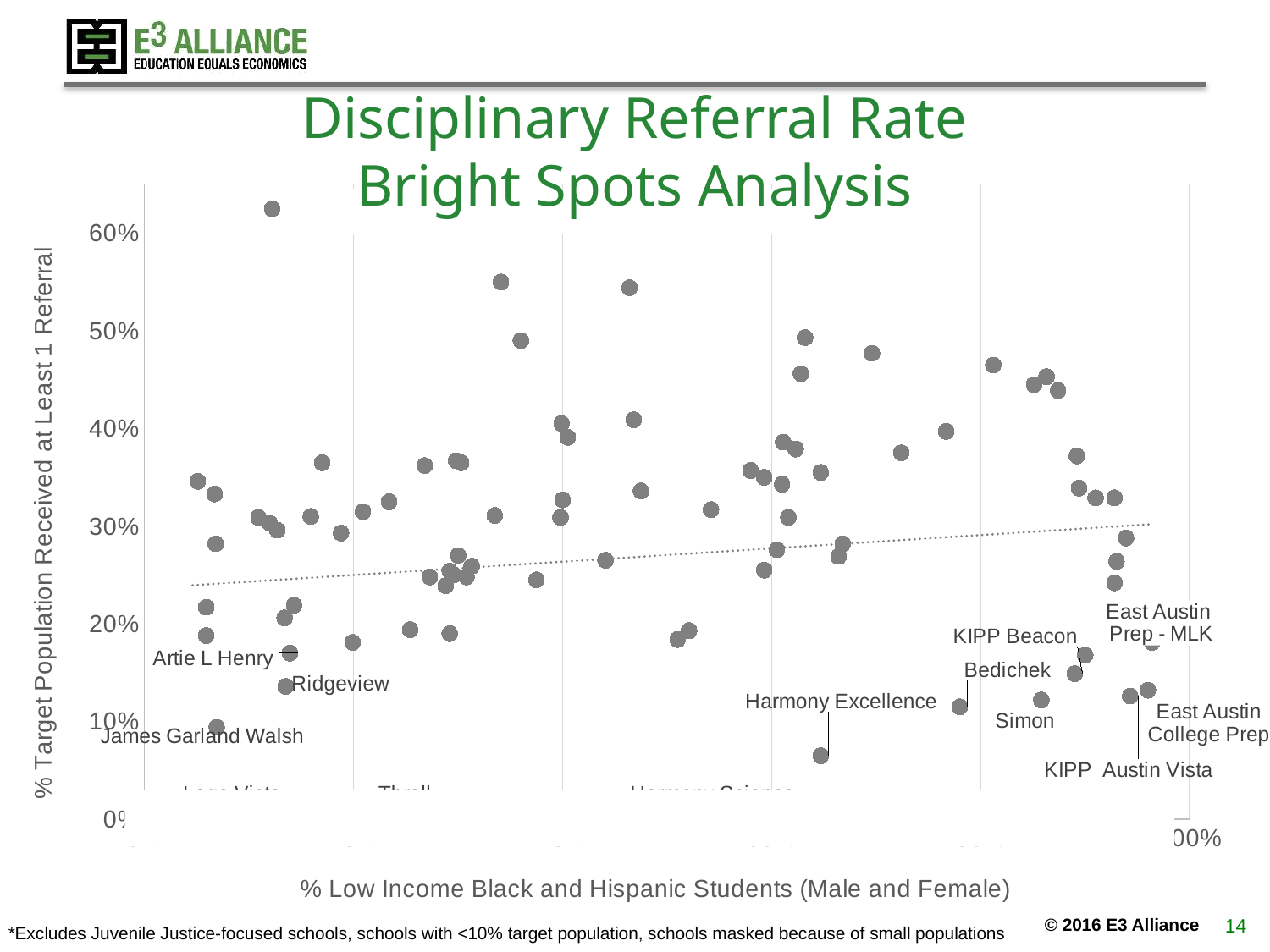
Is the value for Simon greater or less than 20%? less Does the dotted trend line rise or fall as the x axis increases? Rises Is the highest point on the chart greater or less than 60%? greater Is the value for Harmony Excellence greater or less than 10%? less What kind of chart is shown on the slide? Scatter plot What is the label of the x axis? % Low Income Black and Hispanic Students (Male and Female) What is the title of the chart? Disciplinary Referral Rate Bright Spots Analysis